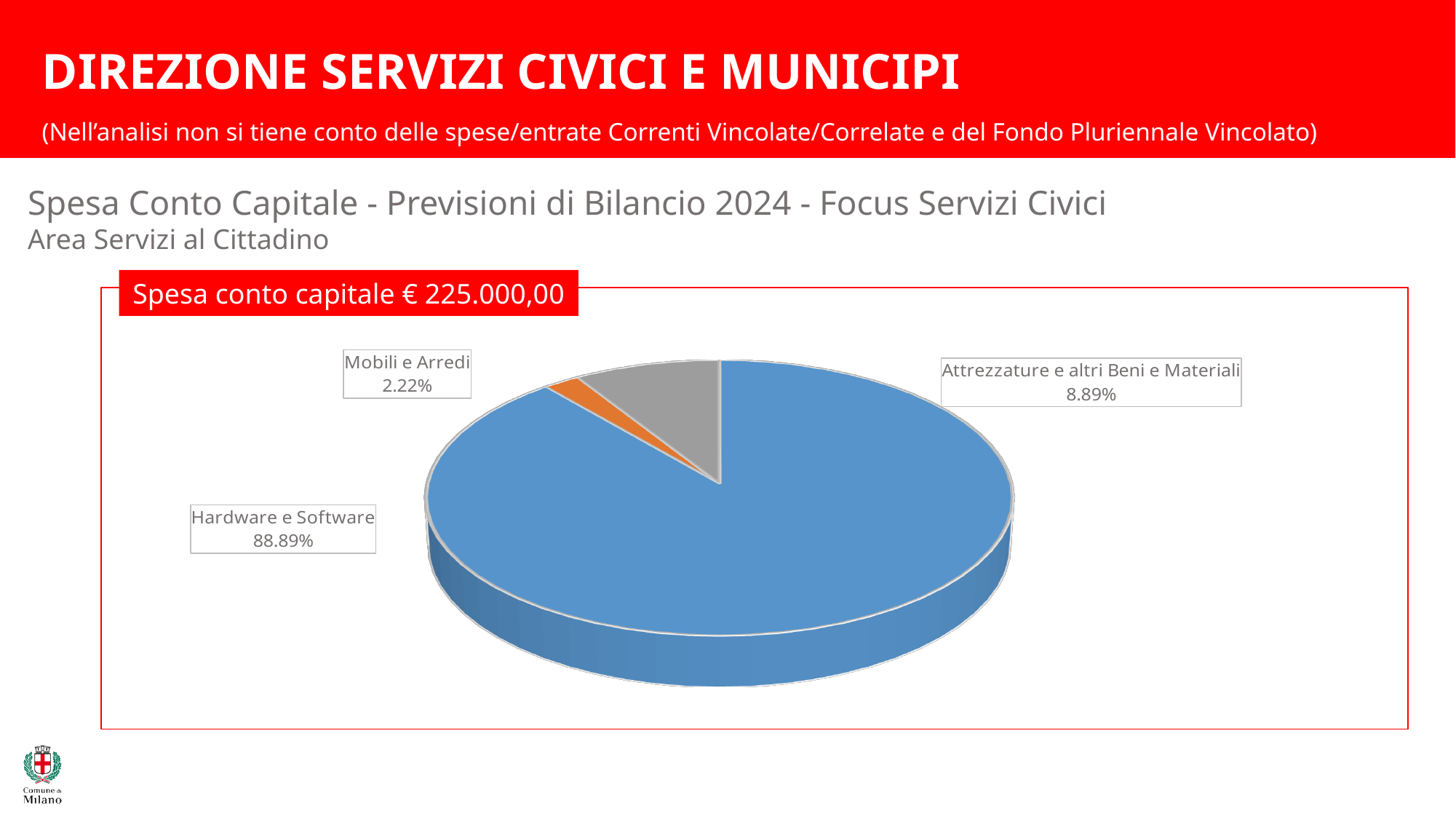
What is the difference in percentage points between Attrezzature e altri Beni e Materiali and Mobili e Arredi? 6.67% What total capital expenditure amount is shown in the red box above the chart? € 225.000,00 What kind of chart is shown on the slide? Pie chart What share of the pie does Mobili e Arredi represent? 2.22% What colour is the slice for Mobili e Arredi? Orange Which is larger: the share for Attrezzature e altri Beni e Materiali or the share for Mobili e Arredi? Attrezzature e altri Beni e Materiali Which category has the smallest slice of the pie? Mobili e Arredi Which category has the largest slice of the pie? Hardware e Software What is the difference in percentage points between Hardware e Software and Attrezzature e altri Beni e Materiali? 80.00% What share of the pie does Attrezzature e altri Beni e Materiali represent? 8.89% How many categories are shown in the pie chart? 3 What share of the pie does Hardware e Software represent? 88.89%